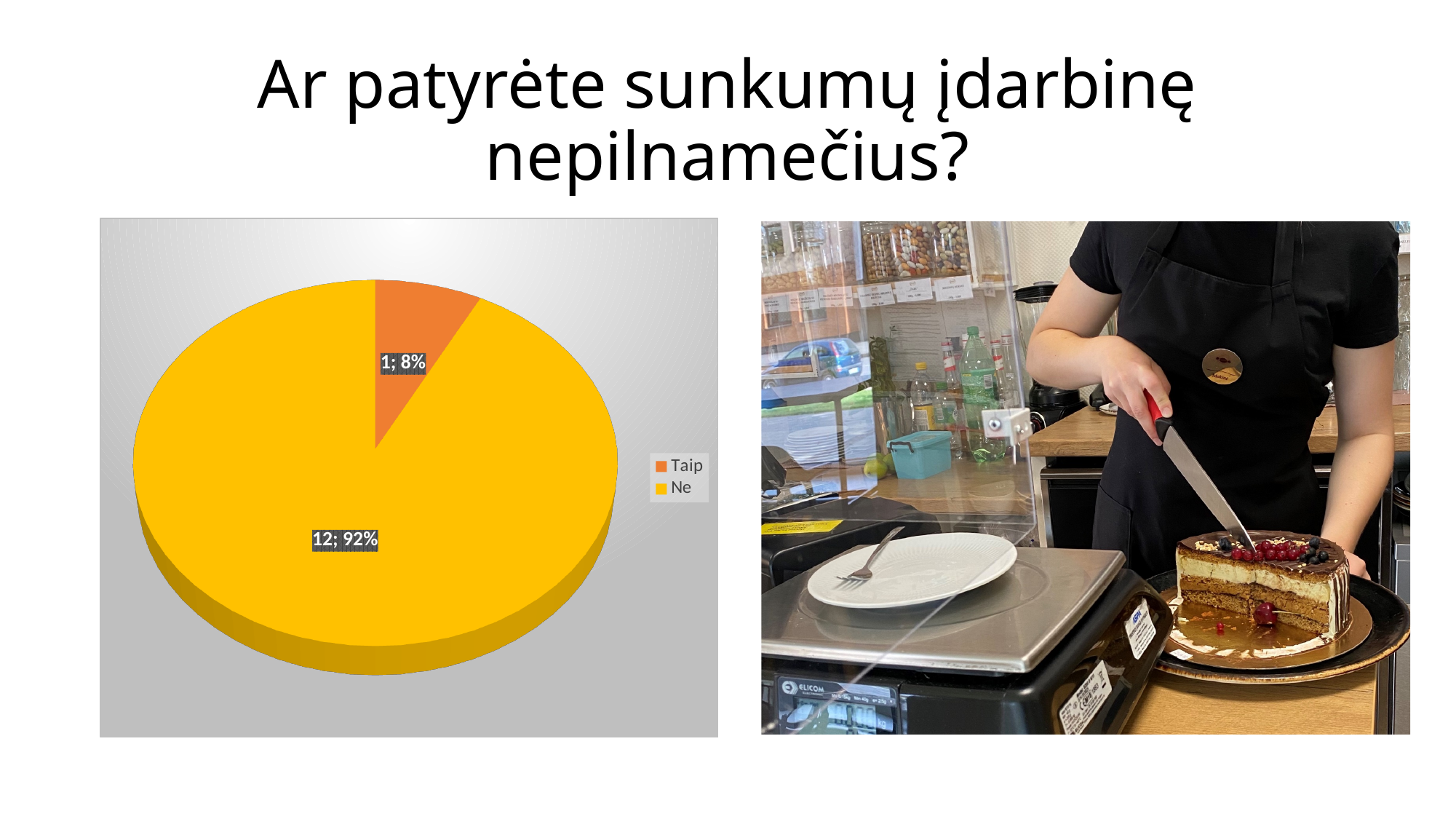
What colour is the 'Taip' slice in the pie chart? orange How many slices does the pie chart have? 2 Which slice of the pie chart is the largest? Ne What kind of chart is shown on the slide? pie chart What is the count shown for the 'Ne' slice of the pie chart? 12 Which slice of the pie chart is the smallest? Taip What is the difference between the counts for 'Ne' and 'Taip' in the pie chart? 11 What share of the pie does the 'Ne' slice represent? 92% How many entries does the legend of the pie chart list? 2 Which is larger in the pie chart, 'Taip' or 'Ne'? Ne What is the count shown for the 'Taip' slice of the pie chart? 1 What share of the pie does the 'Taip' slice represent? 8%